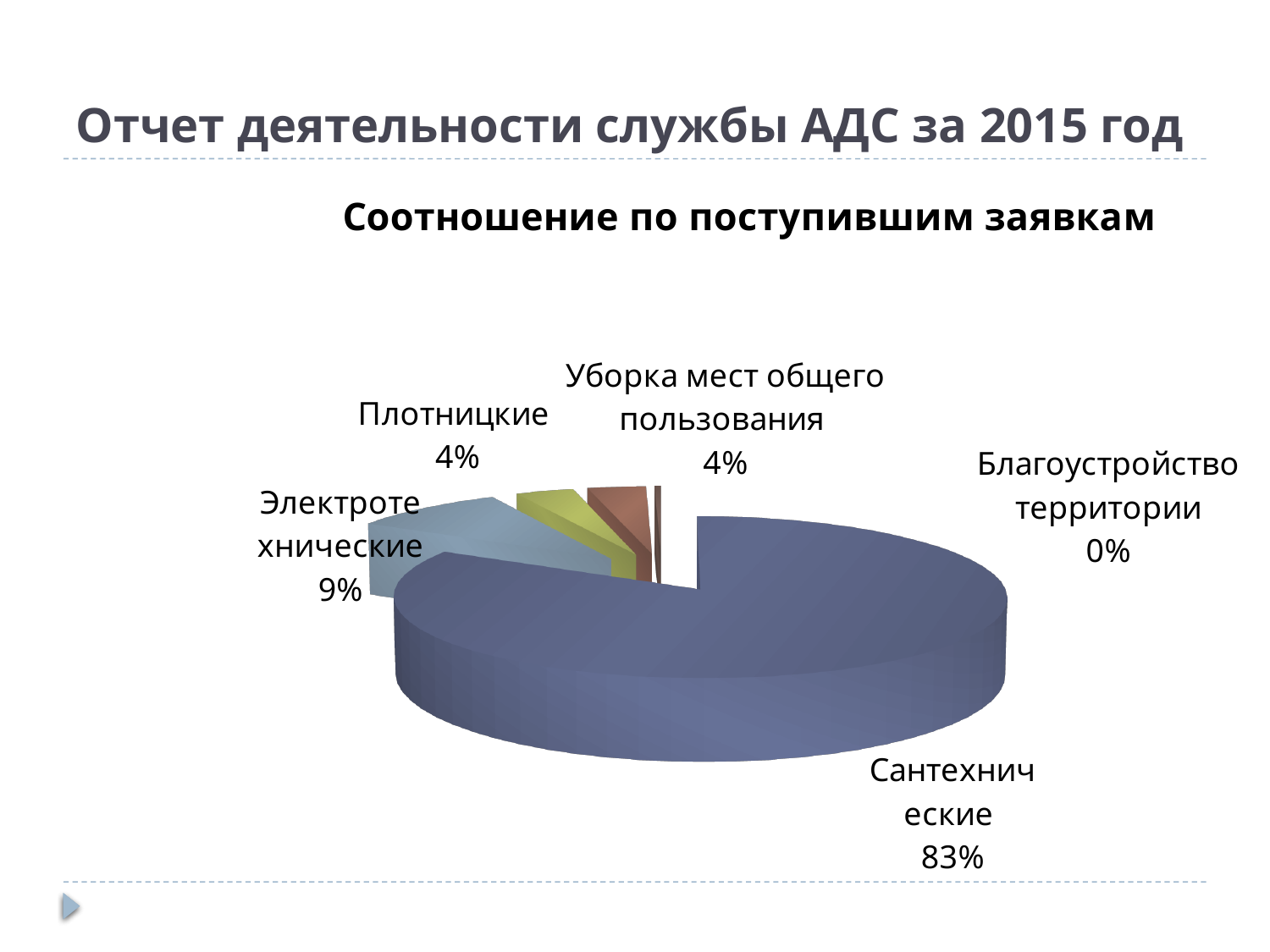
Which category has the largest share of the pie? Сантехнические What share of the pie does Сантехнические have? 83% What kind of chart is shown on the slide? Pie chart Which is larger, the share of Электротехнические or the share of Плотницкие? Электротехнические What is the title of the chart? Соотношение по поступившим заявкам Which category has the smallest share of the pie? Благоустройство территории What share of the pie does Плотницкие have? 4% What share of the pie does Электротехнические have? 9% What is the difference between the shares of Сантехнические and Электротехнические? 74% How many categories are shown in the pie chart? 5